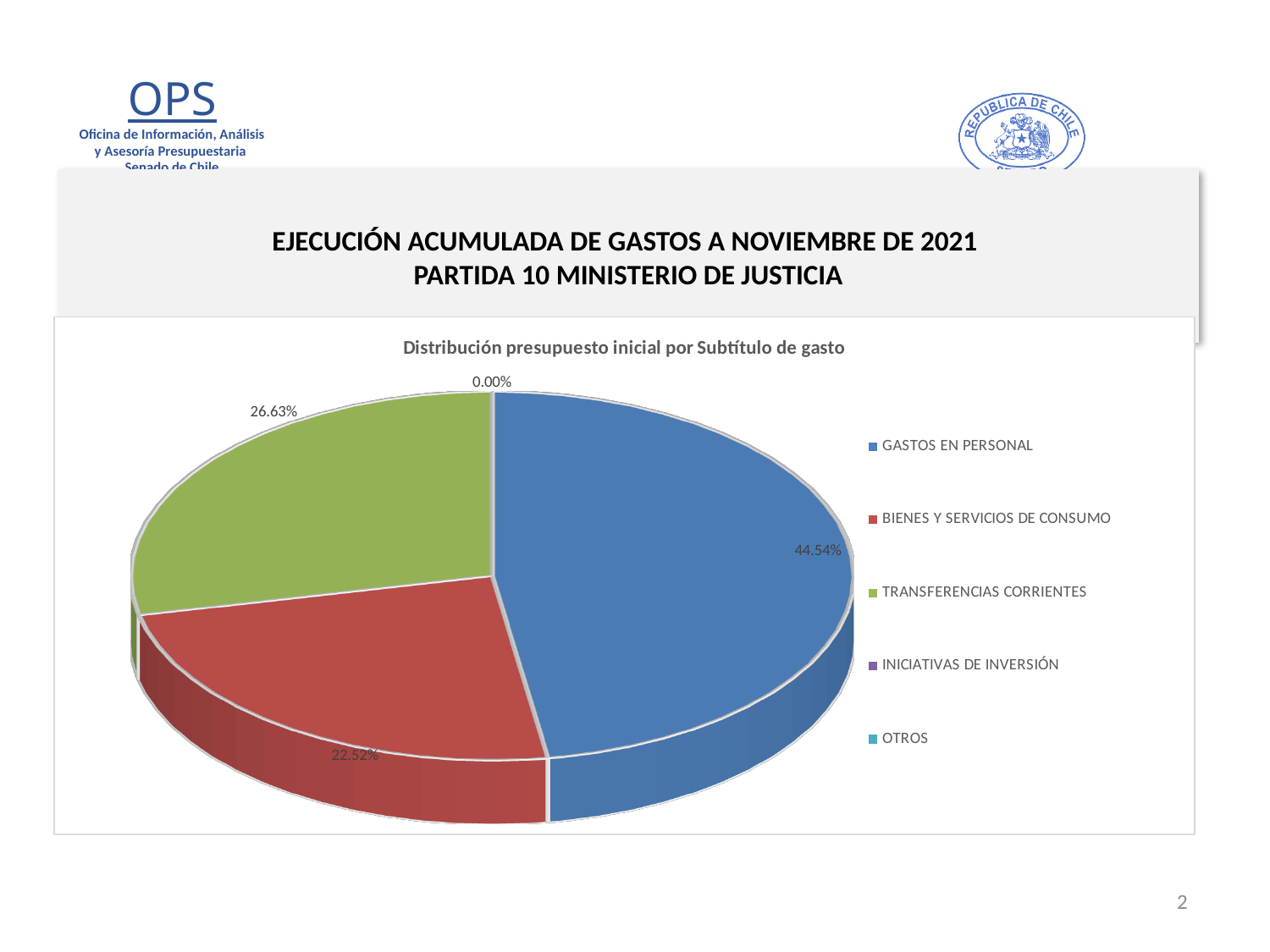
What share of the pie does GASTOS EN PERSONAL represent? 44.54% What is the title of the chart? Distribución presupuesto inicial por Subtítulo de gasto Which category has the largest slice of the pie? GASTOS EN PERSONAL Which is larger, TRANSFERENCIAS CORRIENTES or BIENES Y SERVICIOS DE CONSUMO? TRANSFERENCIAS CORRIENTES What colour is the slice for GASTOS EN PERSONAL? Blue What percentage is shown for TRANSFERENCIAS CORRIENTES? 26.63% How many categories does the legend list? 5 What percentage is shown for BIENES Y SERVICIOS DE CONSUMO? 22.52% What is the difference in percentage points between TRANSFERENCIAS CORRIENTES and BIENES Y SERVICIOS DE CONSUMO? 4.11 percentage points Which is larger, GASTOS EN PERSONAL or TRANSFERENCIAS CORRIENTES? GASTOS EN PERSONAL What is the difference in percentage points between GASTOS EN PERSONAL and BIENES Y SERVICIOS DE CONSUMO? 22.02 percentage points What kind of chart is shown on the slide? Pie chart